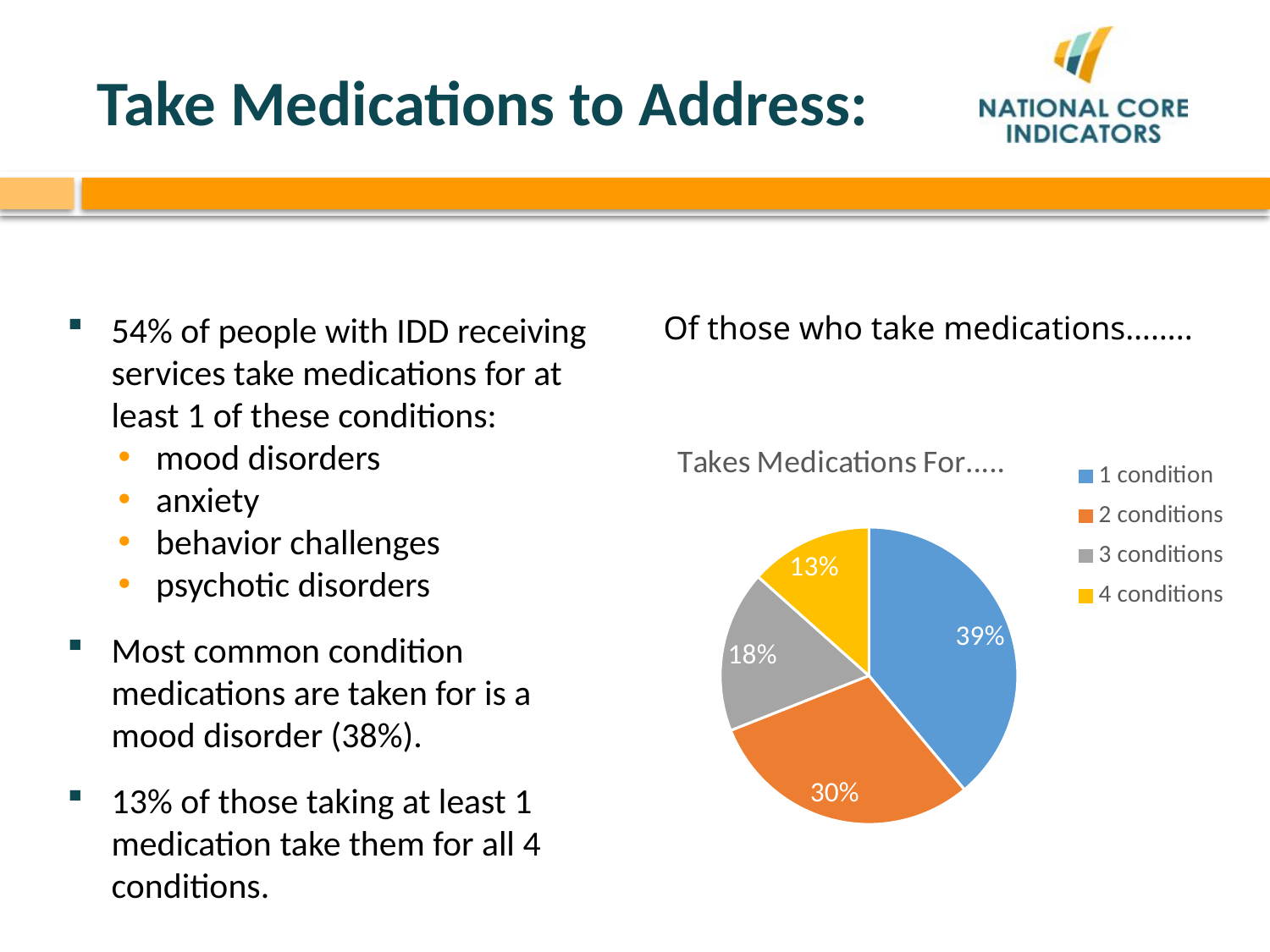
What share of the pie is for 4 conditions? 13% Which is larger, the share for 3 conditions or the share for 4 conditions? 3 conditions What share of the pie is for 1 condition? 39% Which category has the smallest slice of the pie? 4 conditions What is the title of the chart? Takes Medications For..... How many categories does the legend list? 4 What type of chart is shown on the slide? pie chart What colour is the slice for 4 conditions? yellow What share of the pie is for 2 conditions? 30% Which category has the largest slice of the pie? 1 condition What is the difference between the share for 1 condition and the share for 2 conditions? 9% What share of the pie is for 3 conditions? 18%